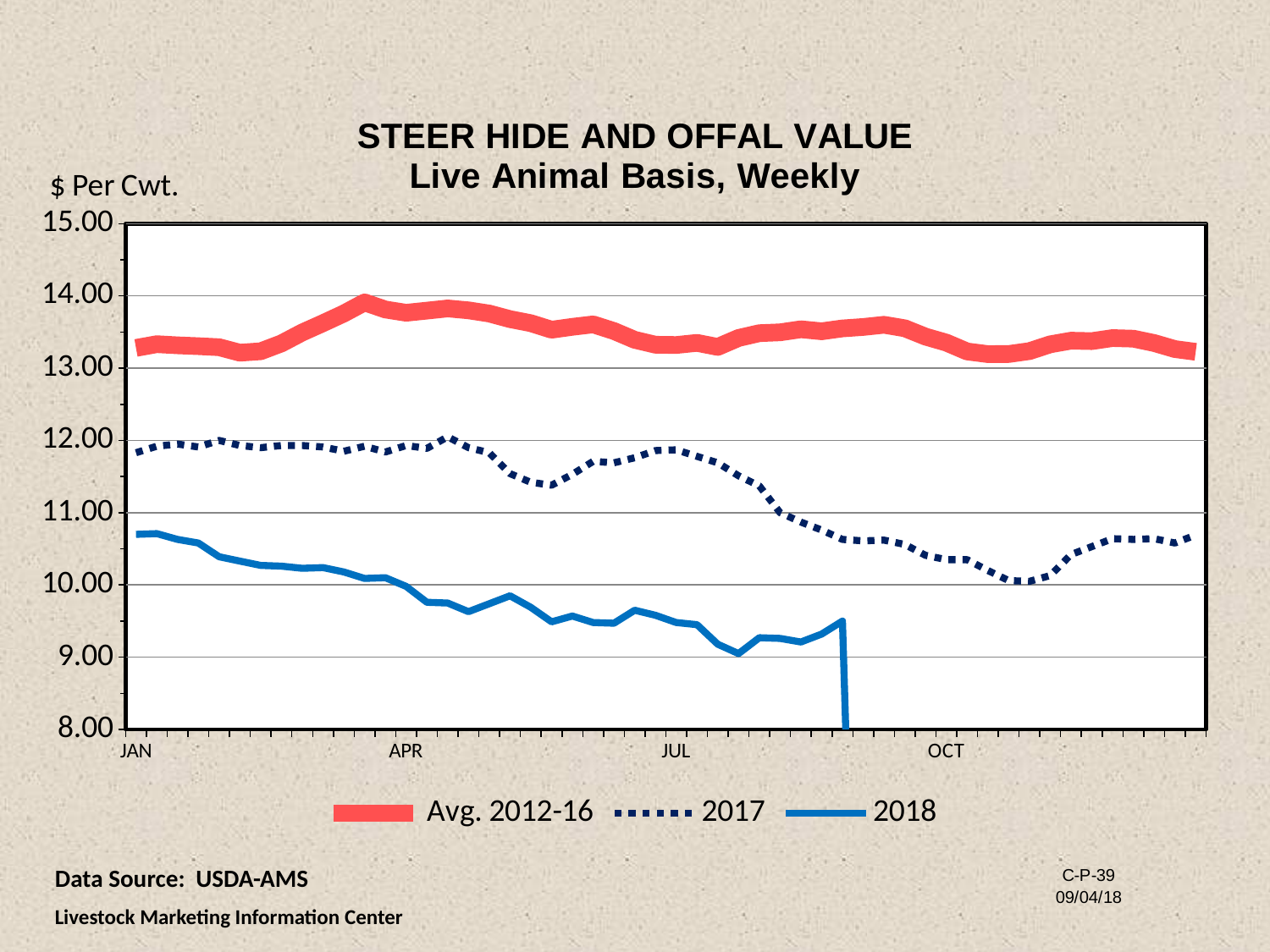
How many series does the legend list? 3 Does the 2018 series rise or fall from JAN to JUL? fall Is the value for 2018 in JUL greater or less than 10.00? less Is the value for 2018 in JAN greater or less than 10.00? greater Which is larger in JAN, the 2017 value or the 2018 value? 2017 Which series has the highest values across the whole year? Avg. 2012-16 Which series has the lowest values across the period it is plotted? 2018 Is the value for Avg. 2012-16 in JAN greater or less than 13.00? greater What unit is shown on the y axis label? $ Per Cwt. What kind of chart is shown on the slide? line chart